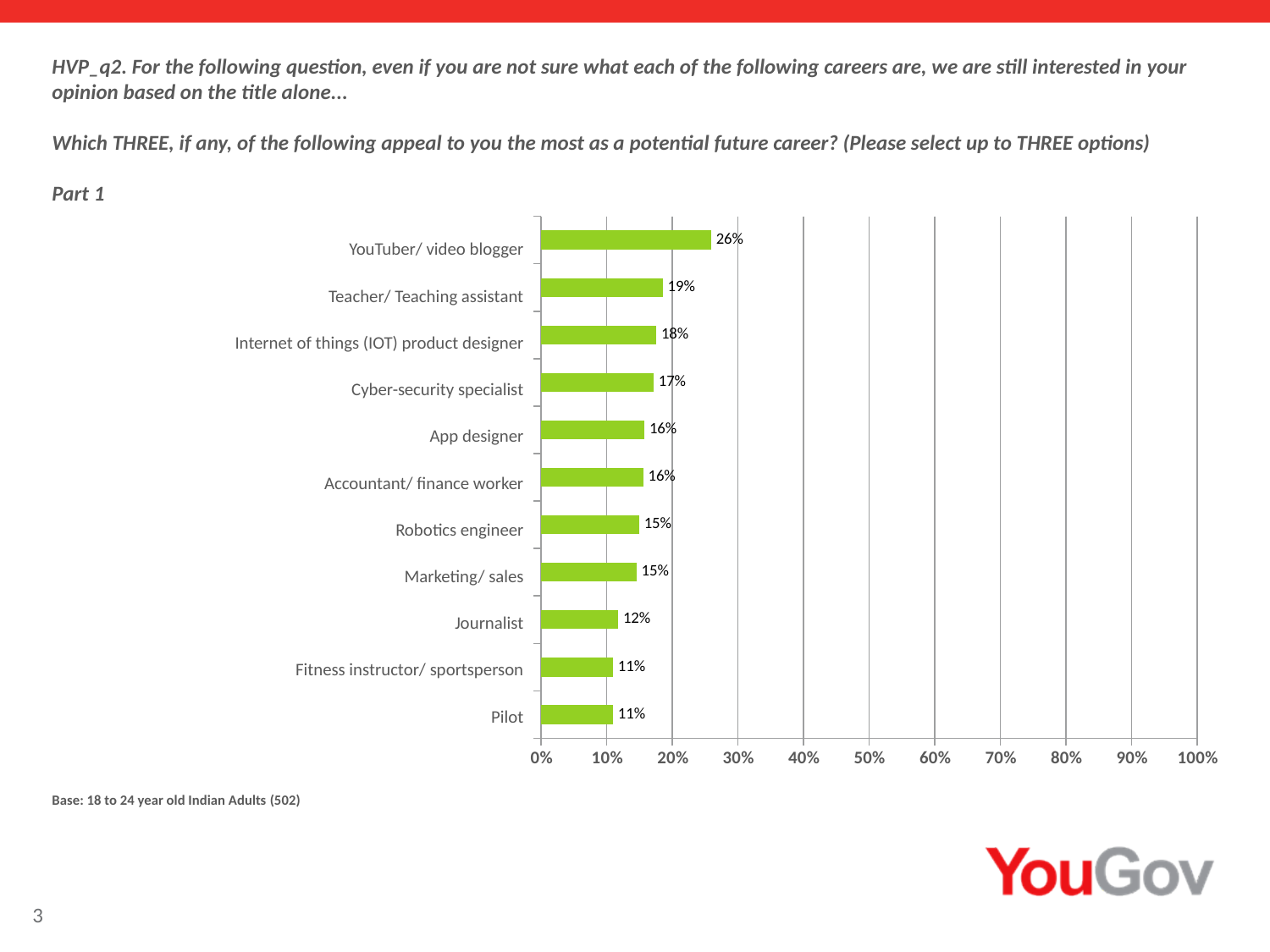
Which career has the highest percentage on the chart? YouTuber/ video blogger What percentage of respondents selected YouTuber/ video blogger as an appealing future career? 26% Is the value for YouTuber/ video blogger greater or less than 20%? greater How many career categories are shown on the chart? 11 What percentage is shown for Journalist? 12% What type of chart is used on this slide? Bar chart What is the value shown for Cyber-security specialist? 17% What is the difference in percentage points between YouTuber/ video blogger and Teacher/ Teaching assistant? 7 What is the value shown for Marketing/ sales? 15% Which has a higher value, Teacher/ Teaching assistant or Robotics engineer? Teacher/ Teaching assistant What is the highest value shown on the horizontal axis of the chart? 100% What is the difference between the values for Internet of things (IOT) product designer and Pilot? 7